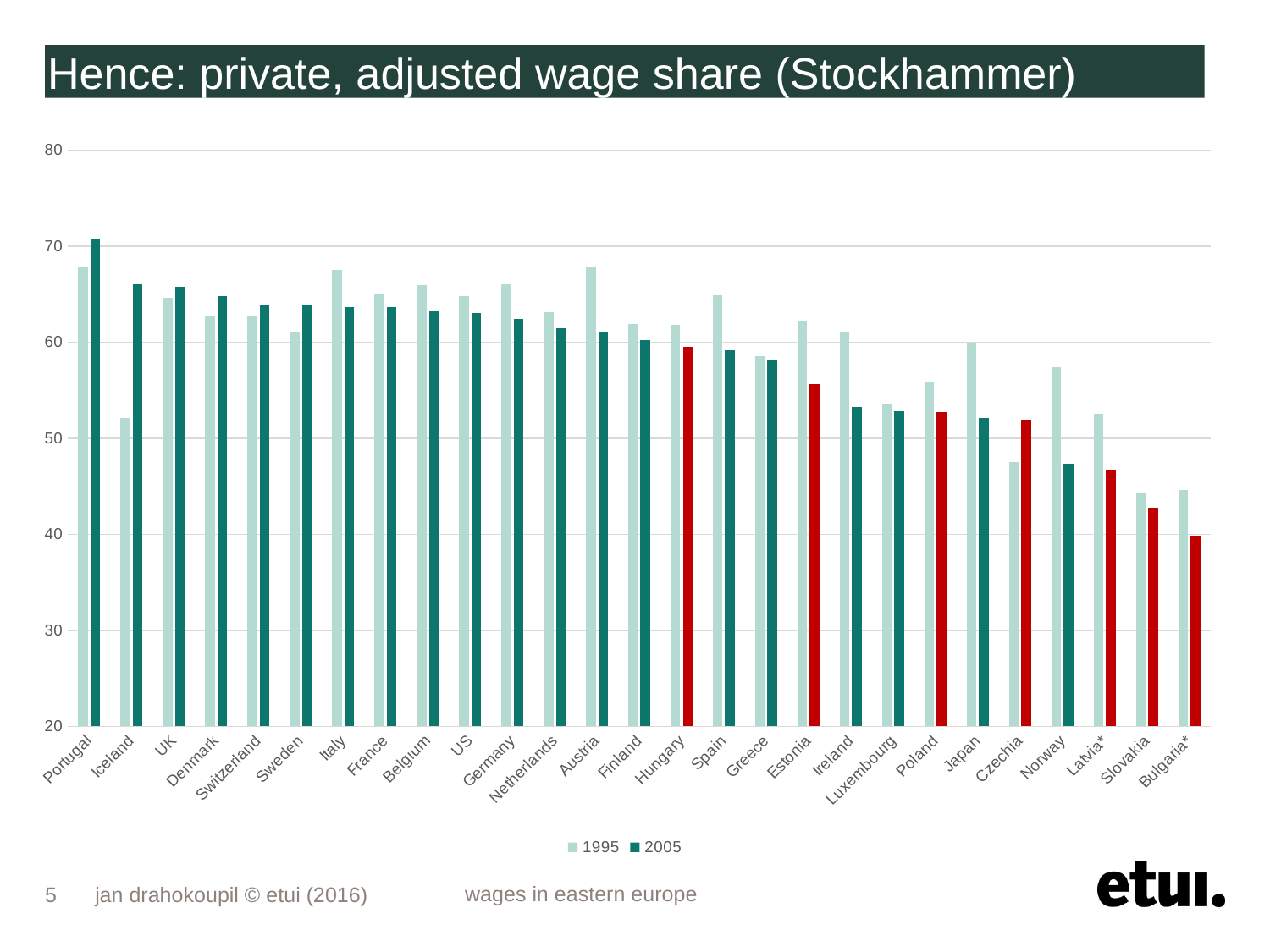
Which country has the lowest 2005 value? Bulgaria* What is the title of the chart slide? Hence: private, adjusted wage share (Stockhammer) How many countries are shown on the x axis? 27 For Japan, which is larger: the 1995 value or the 2005 value? 1995 What kind of chart is shown on the slide? bar chart Is the 1995 value for Iceland greater or less than 50? greater Which country has the highest 2005 value? Portugal Do the 2005 values generally rise or fall moving from left to right along the x axis? fall For Iceland, which is larger: the 1995 value or the 2005 value? 2005 Is the 2005 value for Slovakia greater or less than 40? greater Is the 2005 value for Norway greater or less than 50? less How many series does the legend list? 2